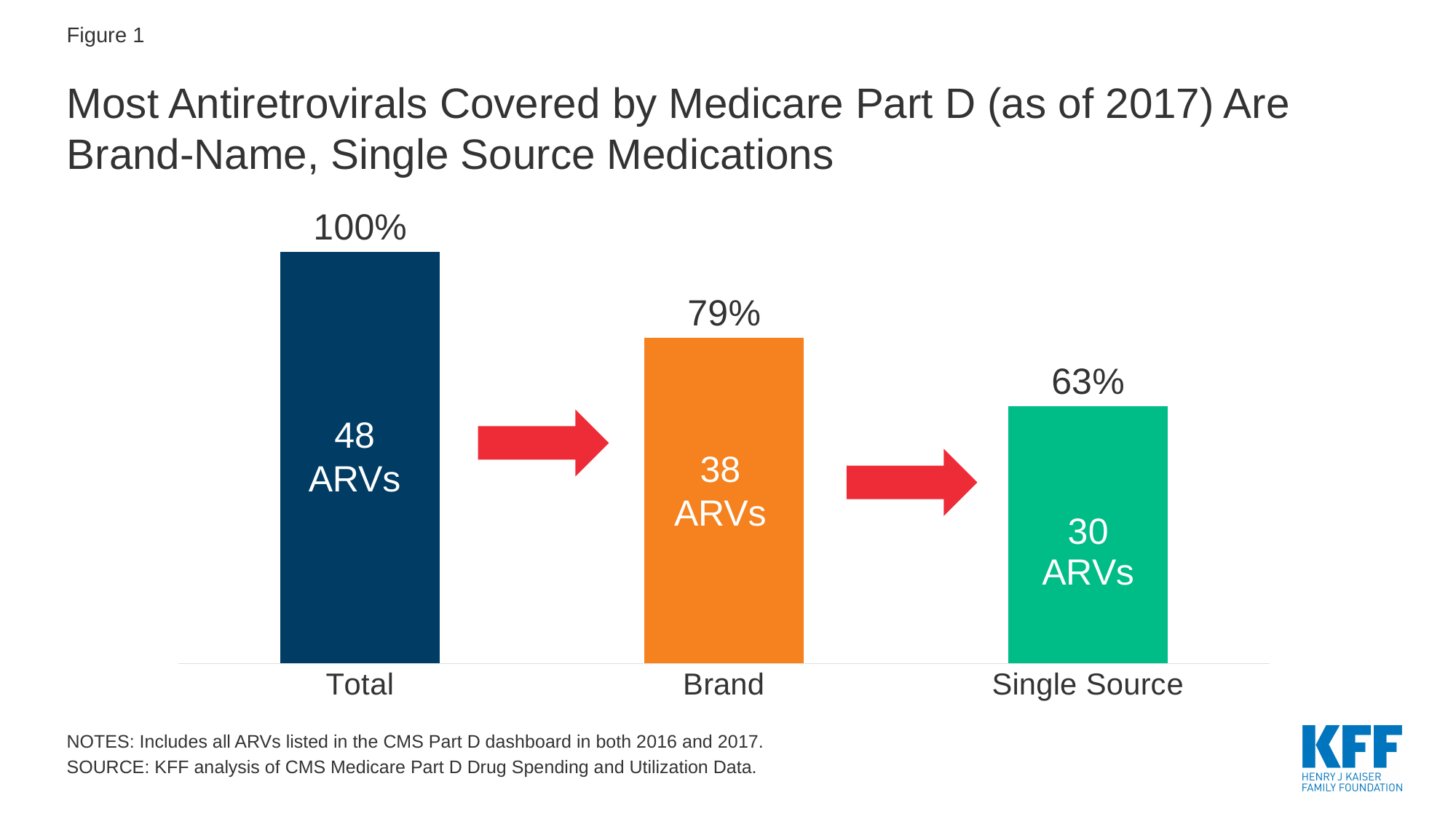
Which category has the lowest percentage? Single Source What is the difference in percentage points between Brand and Single Source? 16 Which category has the highest number of ARVs? Total How many categories are shown on the x axis? 3 How many ARVs are shown for the Single Source bar? 30 ARVs How many ARVs are shown for the Brand bar? 38 ARVs What percentage is shown above the Total bar? 100% What percentage is shown above the Brand bar? 79% What is the difference in the number of ARVs between Total and Brand? 10 Which is larger, the number of ARVs for Brand or for Single Source? Brand What kind of chart is this? Bar chart Do the values rise or fall from left to right across the categories? Fall